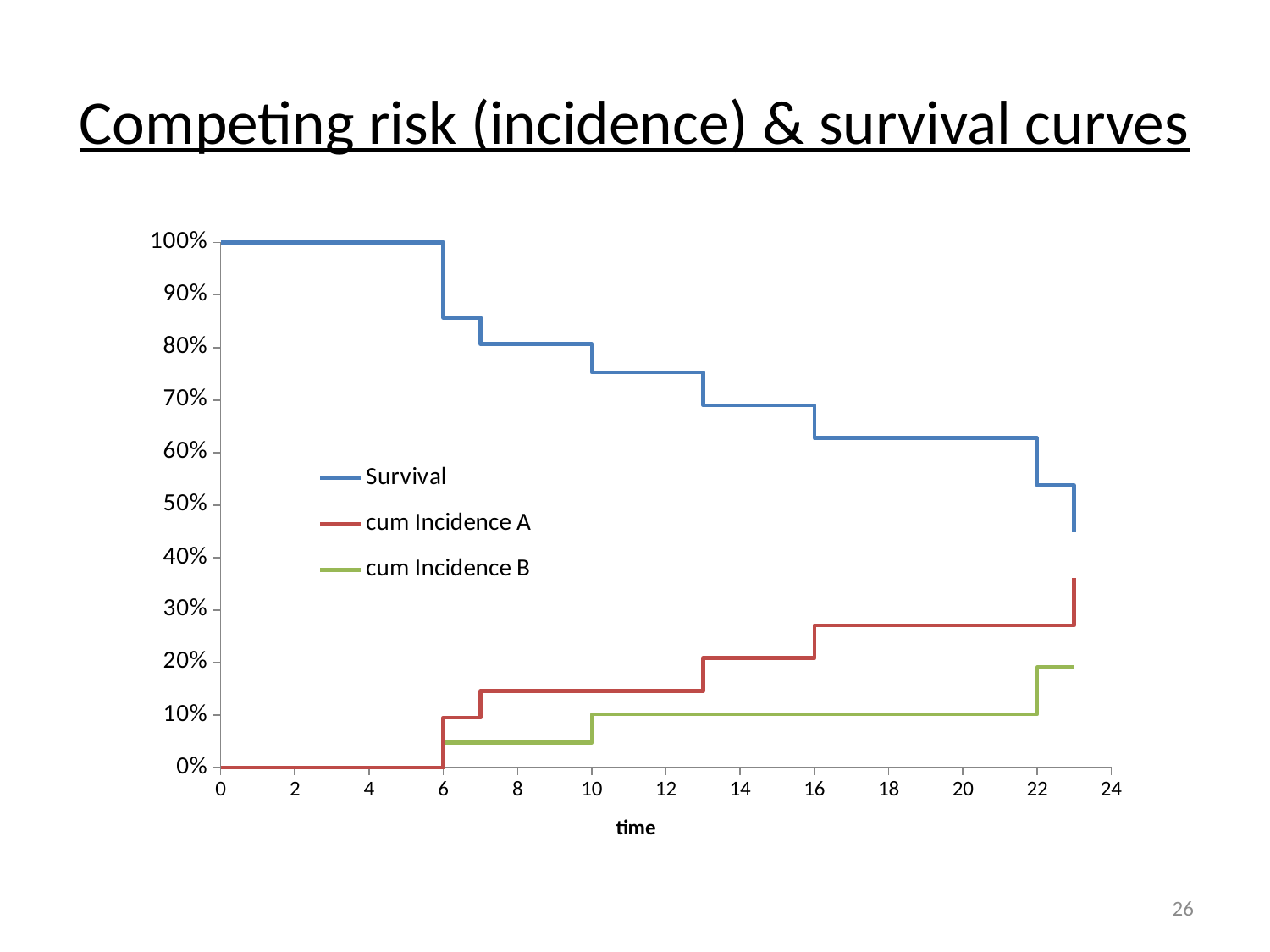
Is the cum Incidence B value at time 8 greater or less than 10%? less What kind of chart is shown on the slide? line chart What is the title of the x axis? time Is the Survival value at time 20 greater or less than 60%? greater Is the cum Incidence A value at time 20 greater or less than 20%? greater Does the Survival curve rise or fall as time increases? fall Which series has the highest value at time 20? Survival How many series does the legend list? 3 At time 20, which is larger: cum Incidence A or cum Incidence B? cum Incidence A What is the value of the Survival series at time 0? 100% What is the value of cum Incidence A at time 2? 0%